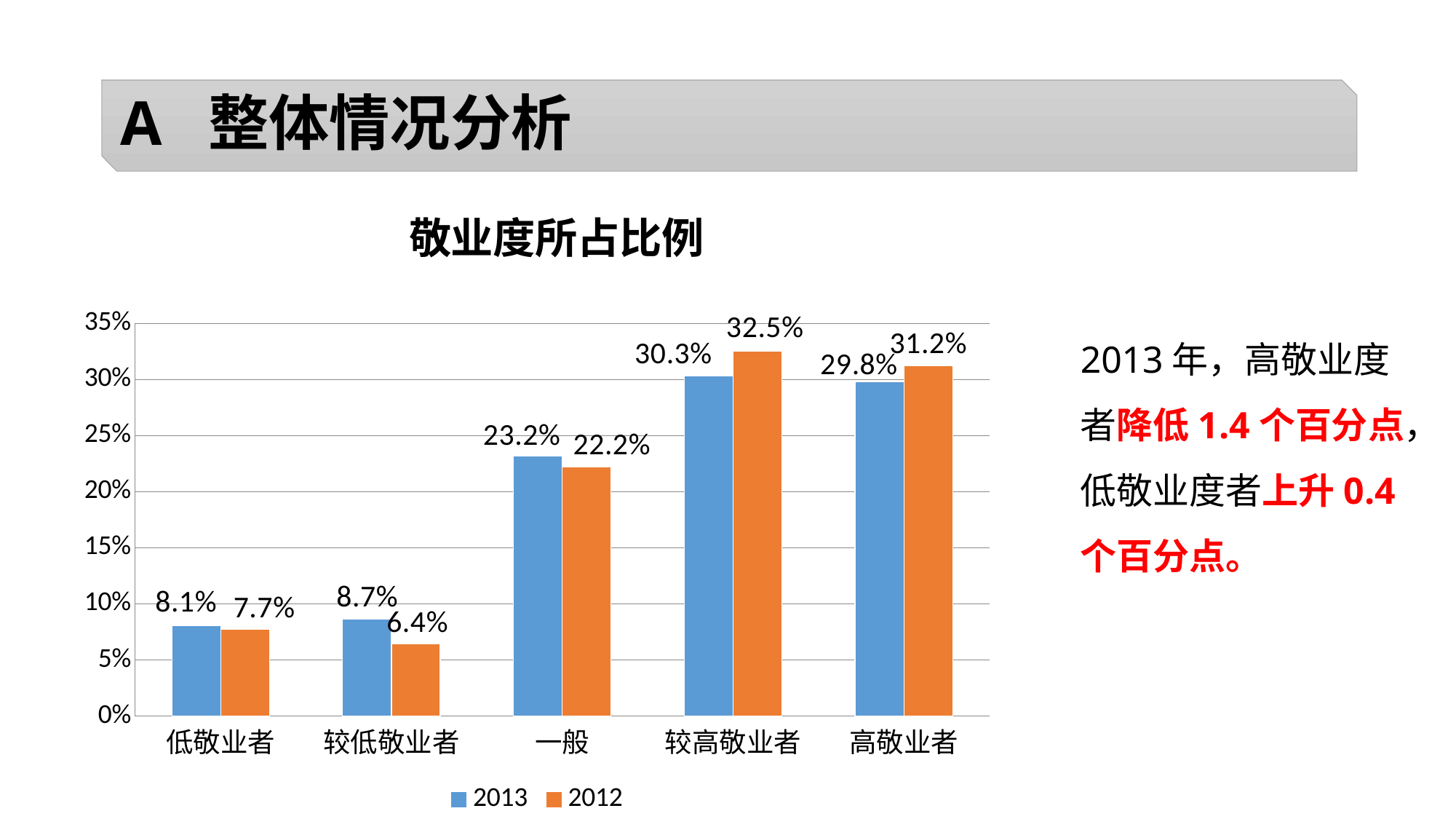
What is the 2013 value for 高敬业者? 29.8% What is the 2012 value for 较高敬业者? 32.5% What is the 2013 value for 低敬业者? 8.1% How many series does the legend list? 2 What kind of chart is shown? bar chart How many categories are shown on the x axis? 5 What is the title of the chart? 敬业度所占比例 What is the 2012 value for 较低敬业者? 6.4% What is the difference between the 2012 and 2013 values for 高敬业者? 1.4% Which category has the highest 2012 value? 较高敬业者 Which is larger for 一般, the 2013 value or the 2012 value? 2013 Which category has the lowest 2013 value? 低敬业者